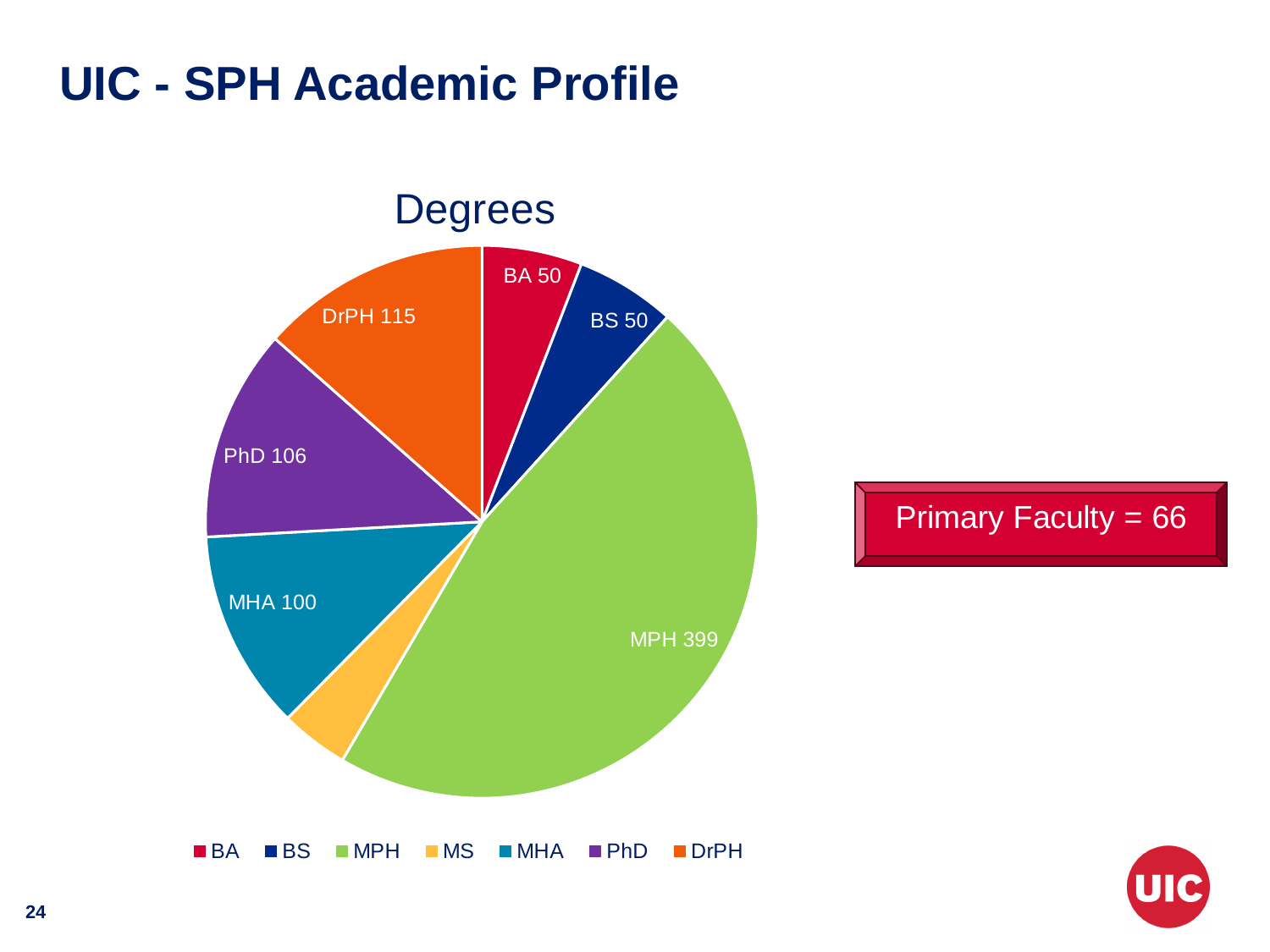
How many degree categories does the legend list? 7 What type of chart is shown on the slide? pie chart What is the value shown for MPH? 399 What is the value shown for PhD? 106 Which is larger, the value for PhD or the value for MHA? PhD What is the value shown for DrPH? 115 What is the value shown for MHA? 100 What colour is the MPH slice? green What is the difference between the DrPH value and the PhD value? 9 Which degree has the largest slice of the pie? MPH What is the title of the chart? Degrees What is the difference between the MPH value and the MHA value? 299